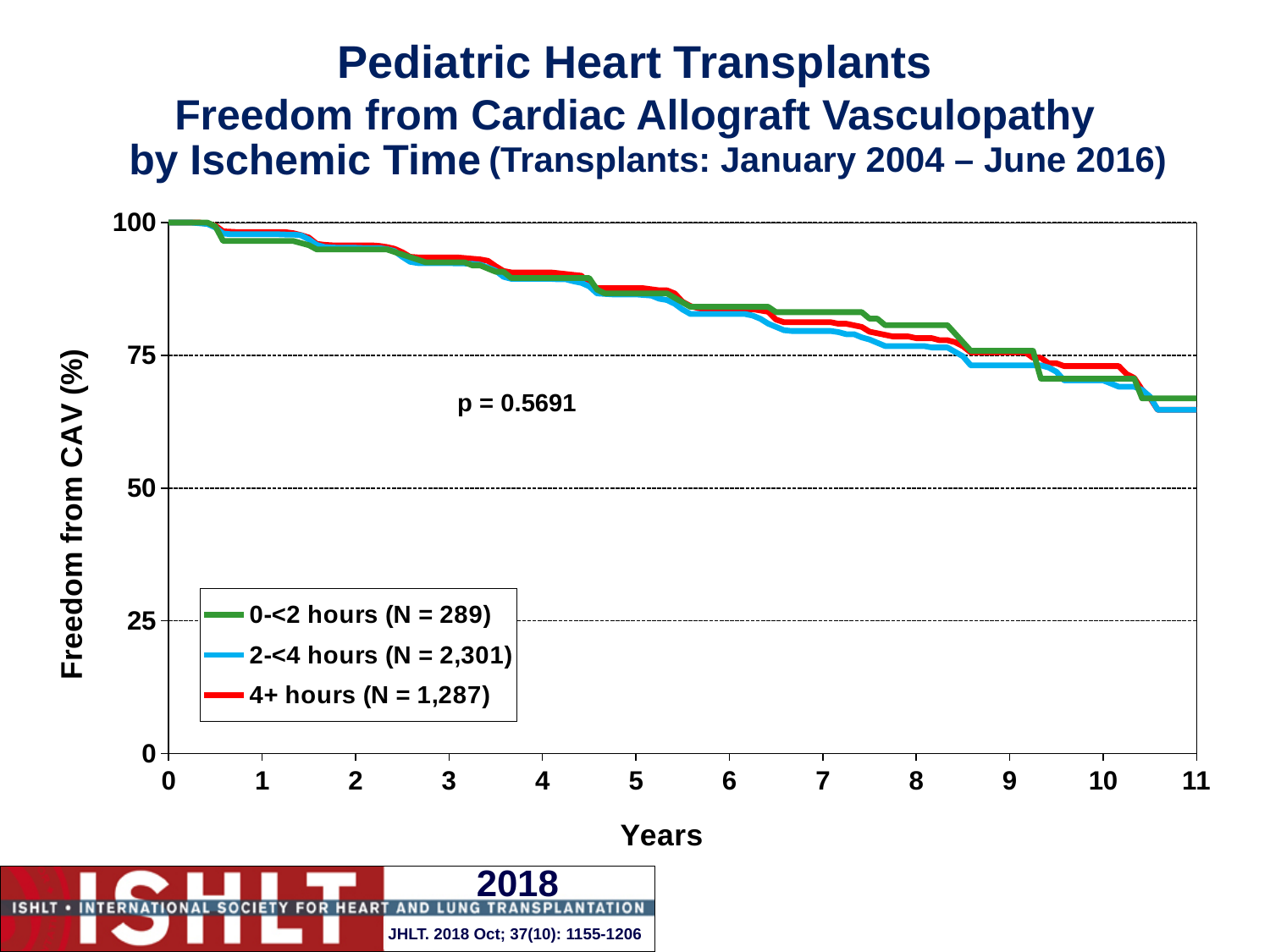
What is the label of the y axis? Freedom from CAV (%) What is the N for the 2-<4 hours group shown in the legend? 2,301 What is the N for the 0-<2 hours group shown in the legend? 289 What is the p-value printed on the chart? p = 0.5691 Which ischemic time group has the largest N in the legend? 2-<4 hours Is the value for the 0-<2 hours group at 11 years greater or less than 75? less Is the value for the 4+ hours group at 5 years greater or less than 75? greater How many series does the legend list? 3 What is the N for the 4+ hours group shown in the legend? 1,287 Do the freedom from CAV curves rise or fall as years increase? fall Which ischemic time group has the smallest N in the legend? 0-<2 hours What kind of chart is shown on the slide? line chart